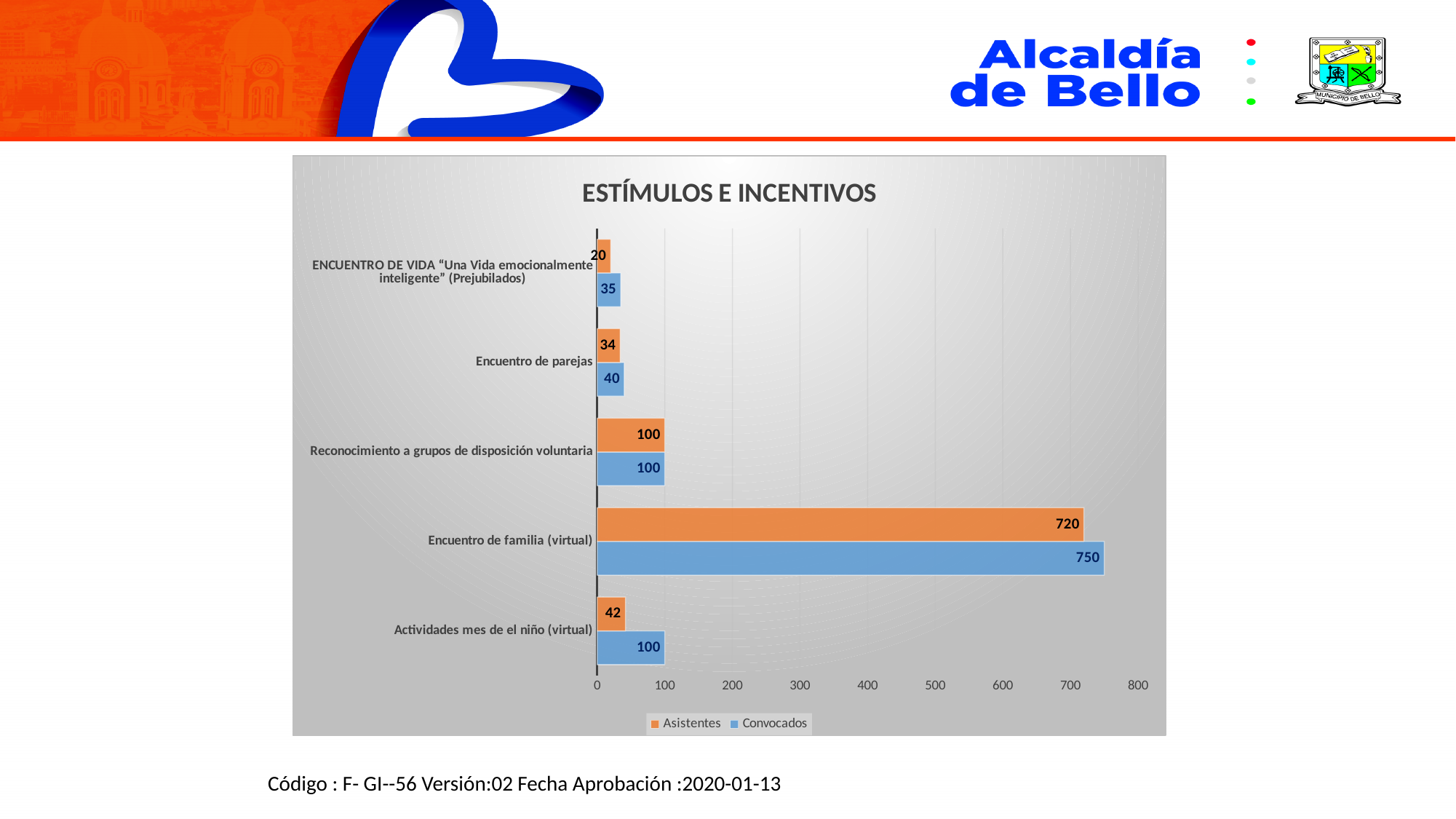
What type of chart is shown on the slide? Bar chart Which is larger for Encuentro de parejas, Asistentes or Convocados? Convocados What is the Asistentes value for Encuentro de parejas? 34 What is the Asistentes value for Actividades mes de el niño (virtual)? 42 How many categories are shown on the chart? 5 What is the Convocados value for Encuentro de familia (virtual)? 750 What is the difference between Convocados and Asistentes for Encuentro de familia (virtual)? 30 Which category has the lowest Asistentes value? ENCUENTRO DE VIDA "Una Vida emocionalmente inteligente" (Prejubilados) How many series does the legend list? 2 Which category has the highest Asistentes value? Encuentro de familia (virtual) What is the difference between Convocados and Asistentes for Actividades mes de el niño (virtual)? 58 What is the Convocados value for ENCUENTRO DE VIDA "Una Vida emocionalmente inteligente" (Prejubilados)? 35